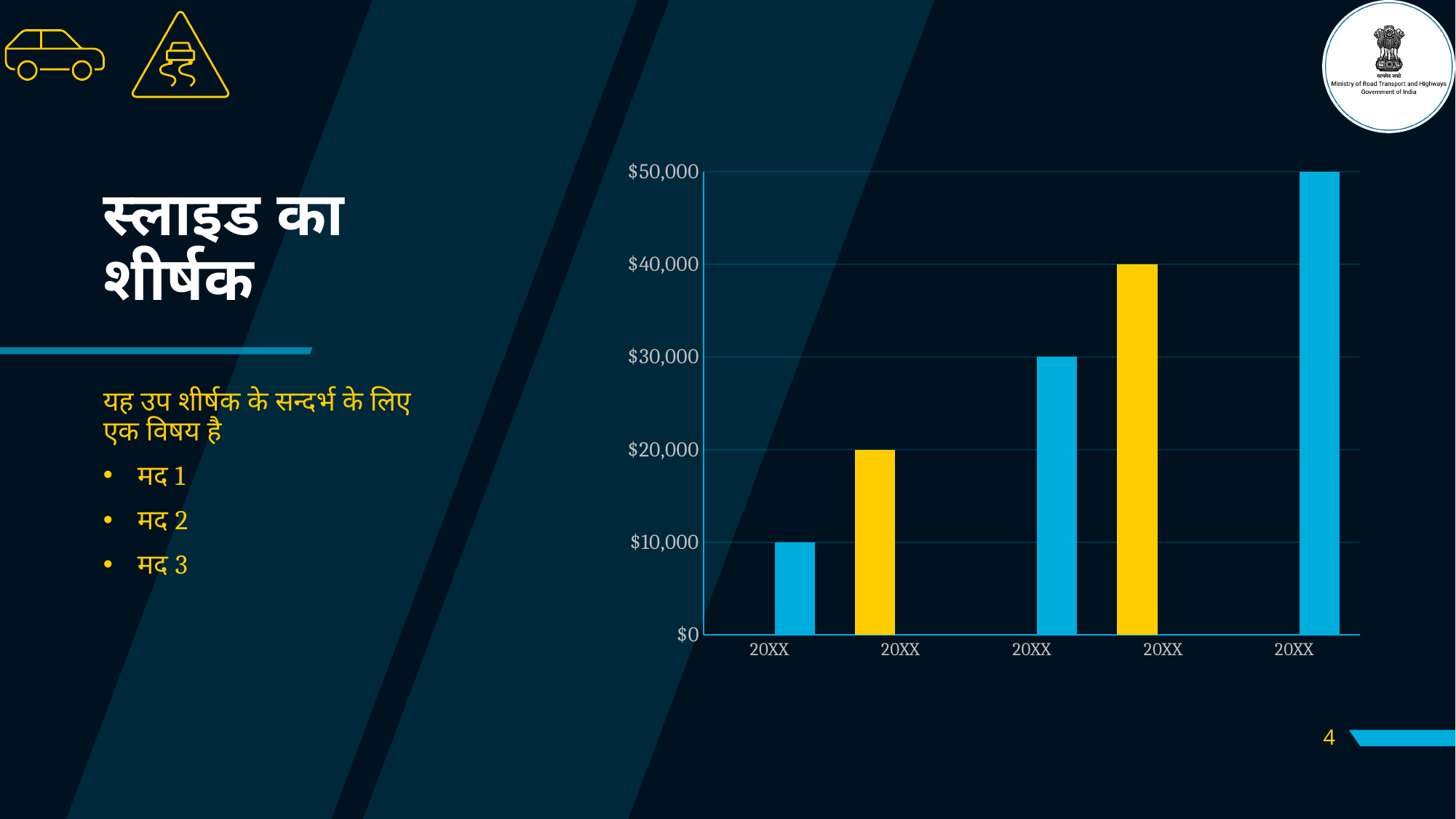
Which bar has the lowest value in the chart? the first (leftmost) bar Is the value of the fourth bar greater or less than $30,000? greater What is the value of the first (leftmost) bar in the chart? $10,000 What is the difference between the value of the fourth bar and the value of the second bar? $20,000 Which is larger, the value of the second bar or the value of the third bar? the third bar How many bars are plotted in the chart? 5 Do the bar values rise or fall from left to right along the x axis? rise What colour are the second and fourth bars in the chart? yellow Which bar has the highest value in the chart? the fifth (rightmost) bar What is the value of the fifth (rightmost) bar in the chart? $50,000 What kind of chart is shown on the slide? bar chart What is the value of the third bar from the left in the chart? $30,000